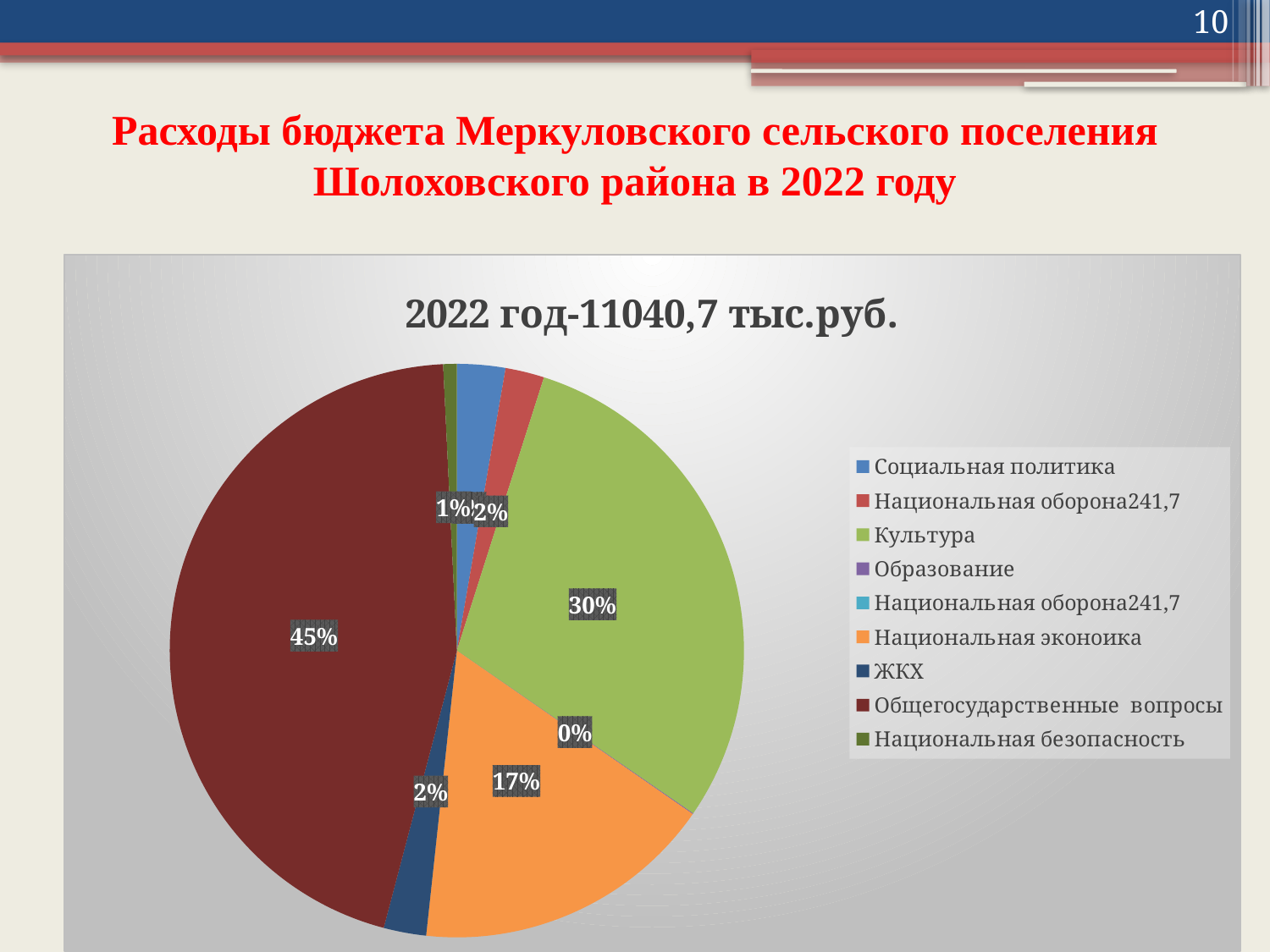
What colour is the slice for Общегосударственные вопросы? dark red Which is larger, the slice for Культура or the slice for Национальная экономика? Культура What share of the pie is labelled for Национальная экономика? 17% What share of the pie is labelled for Образование? 0% What share of the pie is labelled for Общегосударственные вопросы? 45% What is the title of the chart? 2022 год-11040,7 тыс.руб. What kind of chart is shown on the slide? pie chart What is the difference in percentage points between the Общегосударственные вопросы slice and the Культура slice? 15 Which category has the largest slice of the pie? Общегосударственные вопросы How many entries does the chart legend list? 9